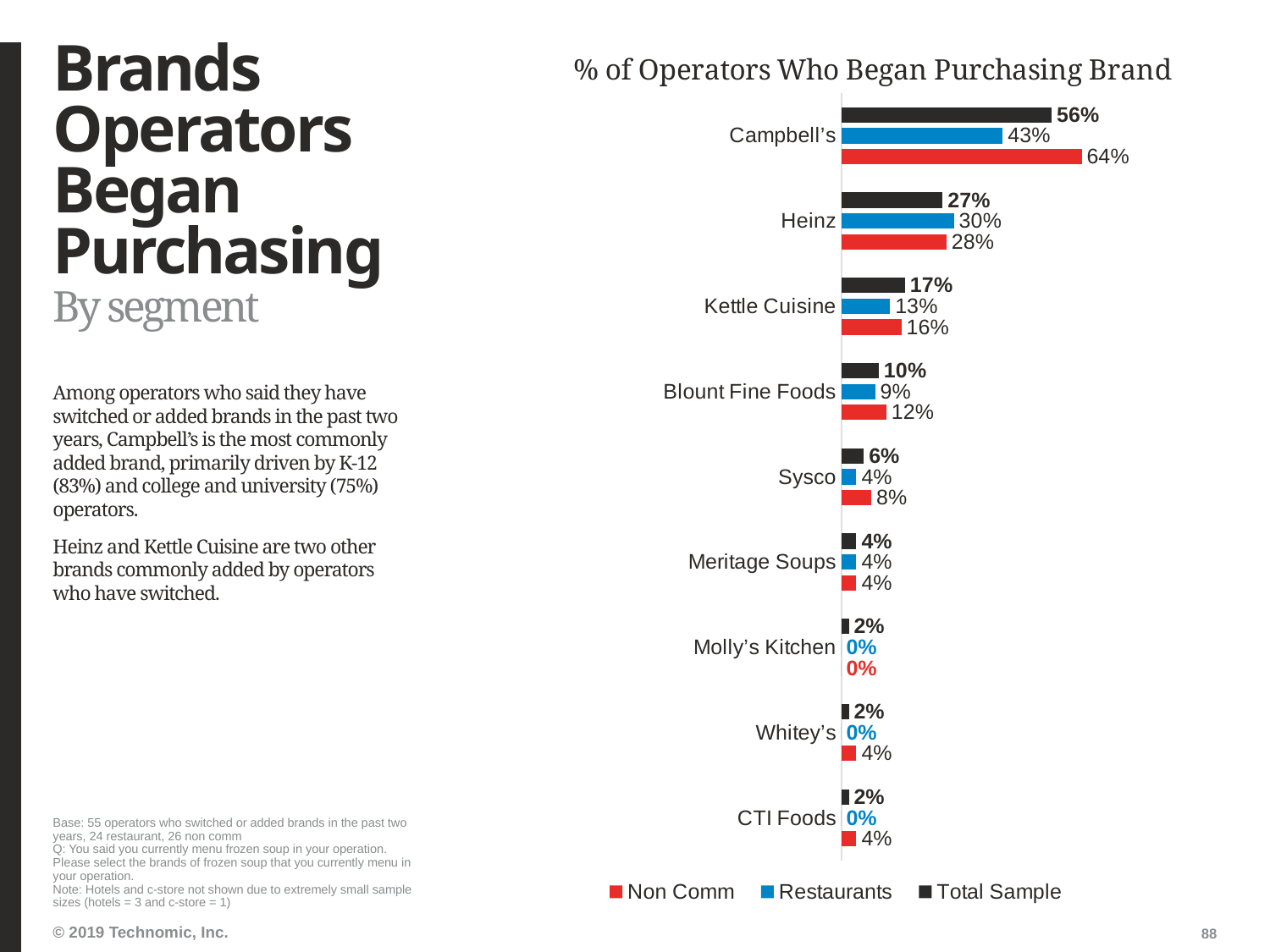
What is the title of the chart? % of Operators Who Began Purchasing Brand How many series does the legend list? 3 Which brand has the lowest Total Sample value among Campbell's, Heinz, Kettle Cuisine, Blount Fine Foods and Sysco? Sysco What is the Non Comm value for Heinz? 28% What is the Total Sample value for Campbell's? 56% What is the difference between the Non Comm and Restaurants values for Campbell's? 21% What kind of chart is shown on the slide? Bar chart How many brands are shown on the chart? 9 What is the Restaurants value for Kettle Cuisine? 13% Which colour represents the Restaurants series? Blue For Heinz, which is larger: the Restaurants value or the Total Sample value? Restaurants Which brand has the highest Non Comm value? Campbell's